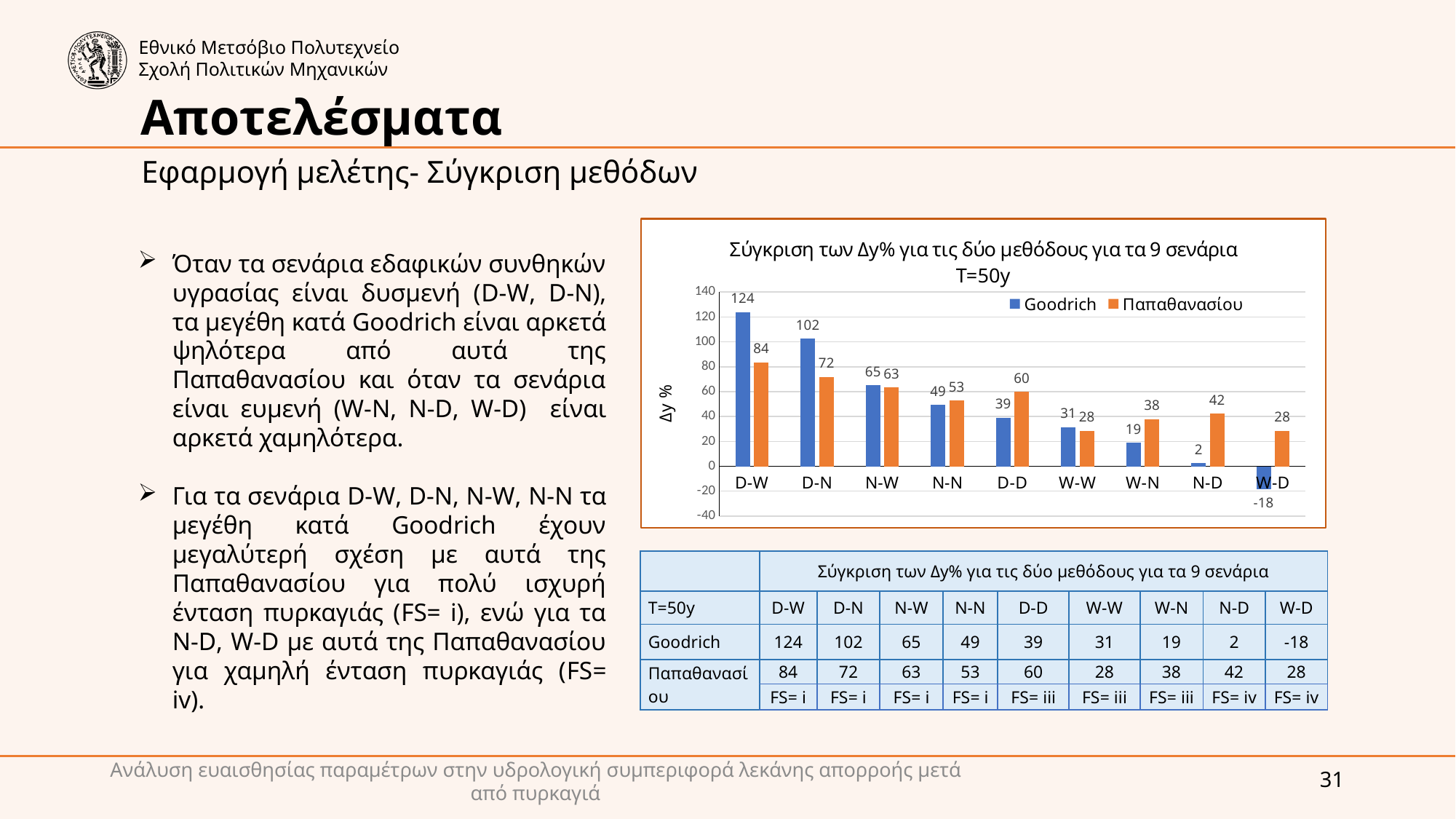
Which scenario has the highest Goodrich value? D-W What is the Παπαθανασίου value for N-D? 42 Do the Goodrich values rise or fall from D-W to W-D? fall What is the difference between the Goodrich and Παπαθανασίου values for D-N? 30 What is the Goodrich value for W-D? -18 What kind of chart is shown? bar chart What is the title of the chart? Σύγκριση των Δy% για τις δύο μεθόδους για τα 9 σενάρια T=50y How many scenarios are shown on the x axis? 9 Which scenario has the lowest Παπαθανασίου value? W-W and W-D (both 28) What is the Goodrich value for D-W? 124 For W-N, which series has the larger value, Goodrich or Παπαθανασίου? Παπαθανασίου How many series does the legend list? 2